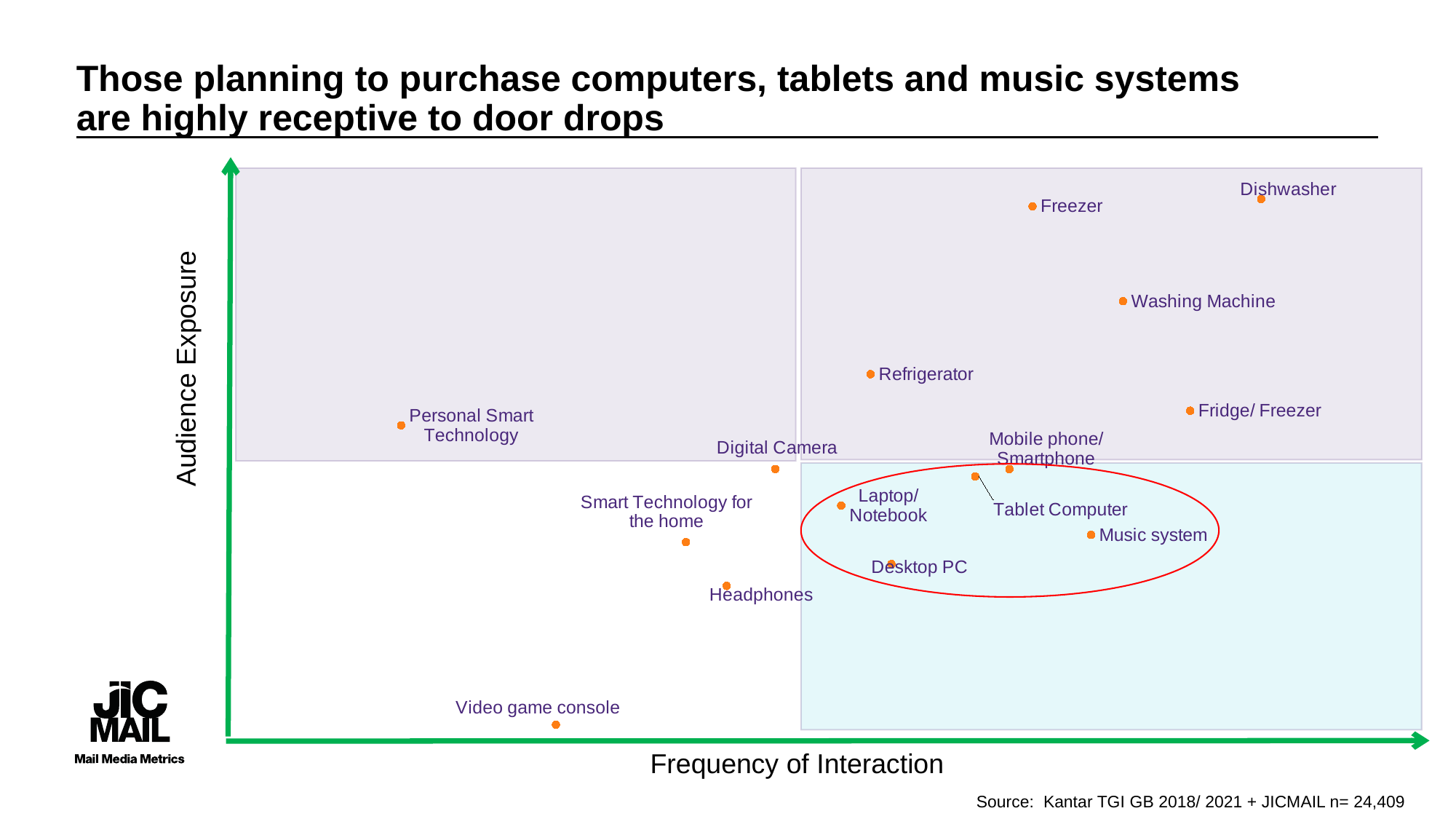
Which has the higher Frequency of Interaction, Video game console or Headphones? Headphones Which has the higher Audience Exposure, Freezer or Refrigerator? Freezer How many products are plotted on the chart? 15 What is the label of the horizontal axis? Frequency of Interaction Which has the higher Audience Exposure, Washing Machine or Fridge/ Freezer? Washing Machine Which product has the lowest Audience Exposure? Video game console Which product has the highest Frequency of Interaction? Dishwasher What kind of chart is shown on the slide? Scatter chart Which product has the lowest Frequency of Interaction? Personal Smart Technology What is the label of the vertical axis? Audience Exposure